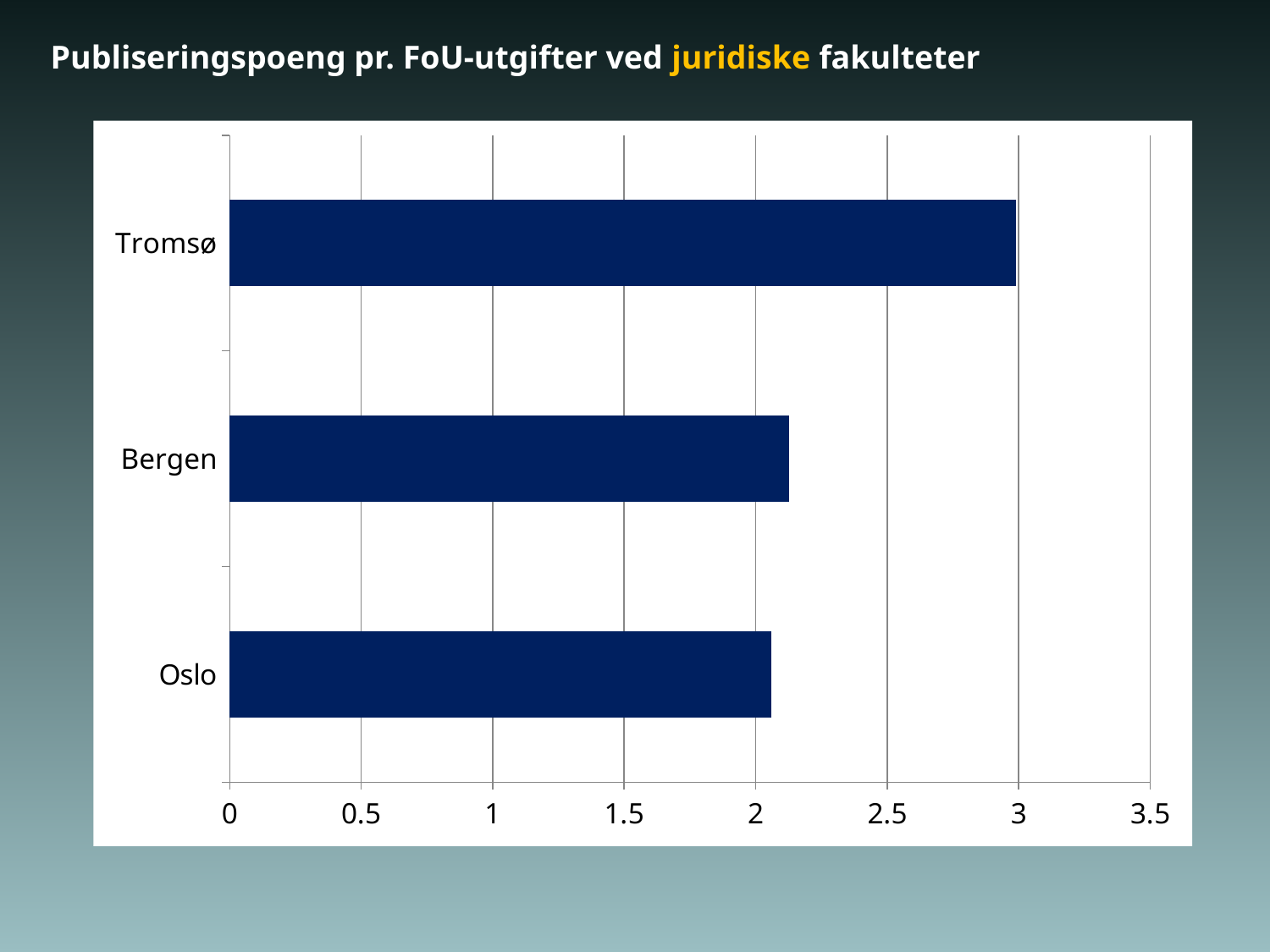
What is the title of the chart on the slide? Publiseringspoeng pr. FoU-utgifter ved juridiske fakulteter Is the value for Tromsø greater or less than 3.5? less Is the value for Oslo greater or less than 2.5? less Is the value for Bergen greater or less than 2? greater What kind of chart is shown on the slide? bar chart How many faculties (categories) are shown in the chart? 3 Which faculty has the highest publication points per R&D expenditure? Tromsø Which is larger, the value for Tromsø or the value for Oslo? Tromsø What is the highest value shown on the horizontal axis? 3.5